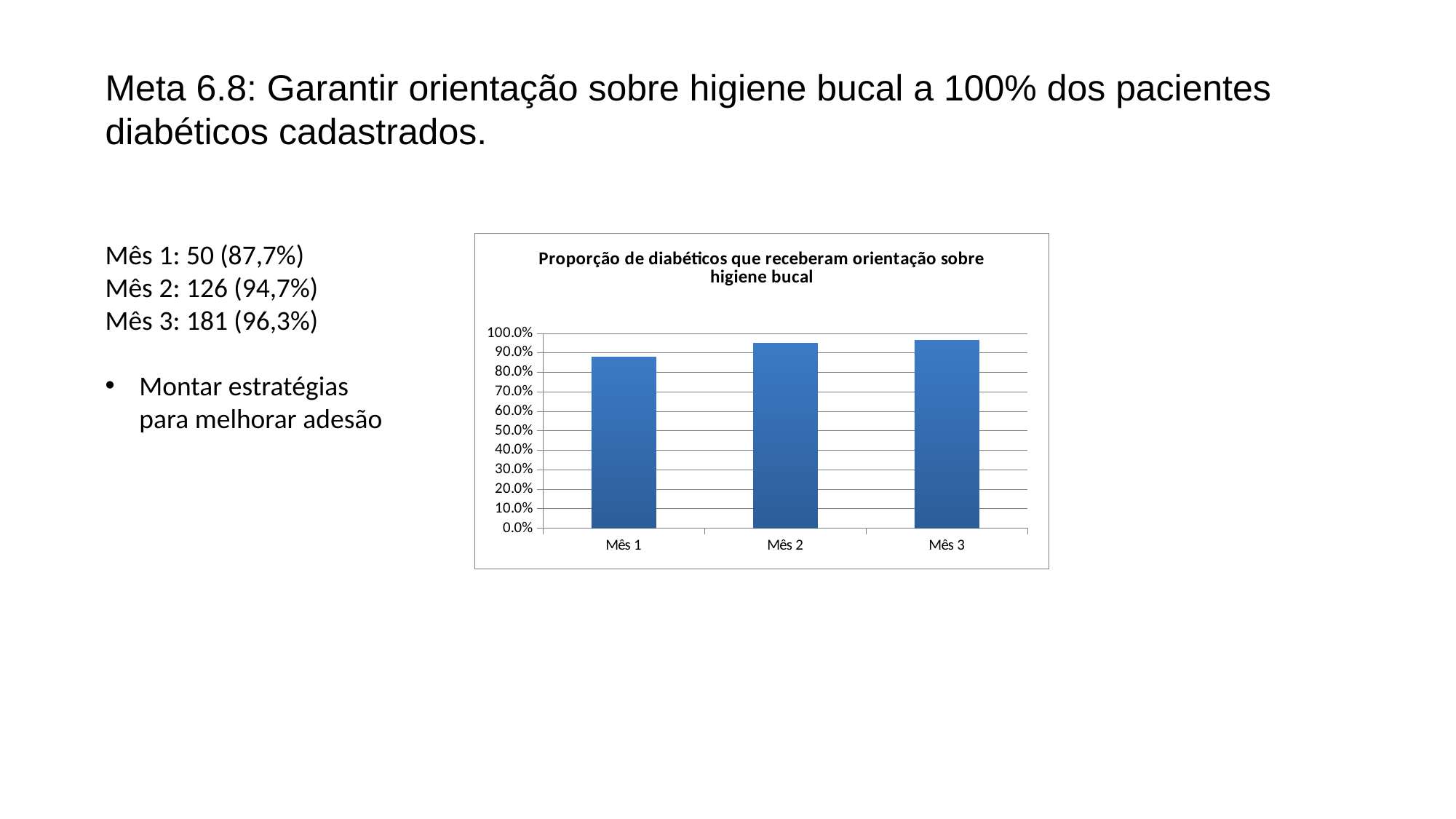
What kind of chart is shown on the slide? bar chart What is the highest tick value shown on the y axis of the chart? 100.0% Which is larger, the value for Mês 1 or the value for Mês 2? Mês 2 How many categories are plotted on the x axis of the chart? 3 Is the value for Mês 3 greater or less than 100.0%? less Is the value for Mês 1 greater or less than 90.0%? less Which month has the highest bar in the chart? Mês 3 What is the title of the chart? Proporção de diabéticos que receberam orientação sobre higiene bucal Which month has the lowest bar in the chart? Mês 1 Is the value for Mês 1 greater or less than 80.0%? greater Do the values rise or fall from Mês 1 to Mês 3? rise